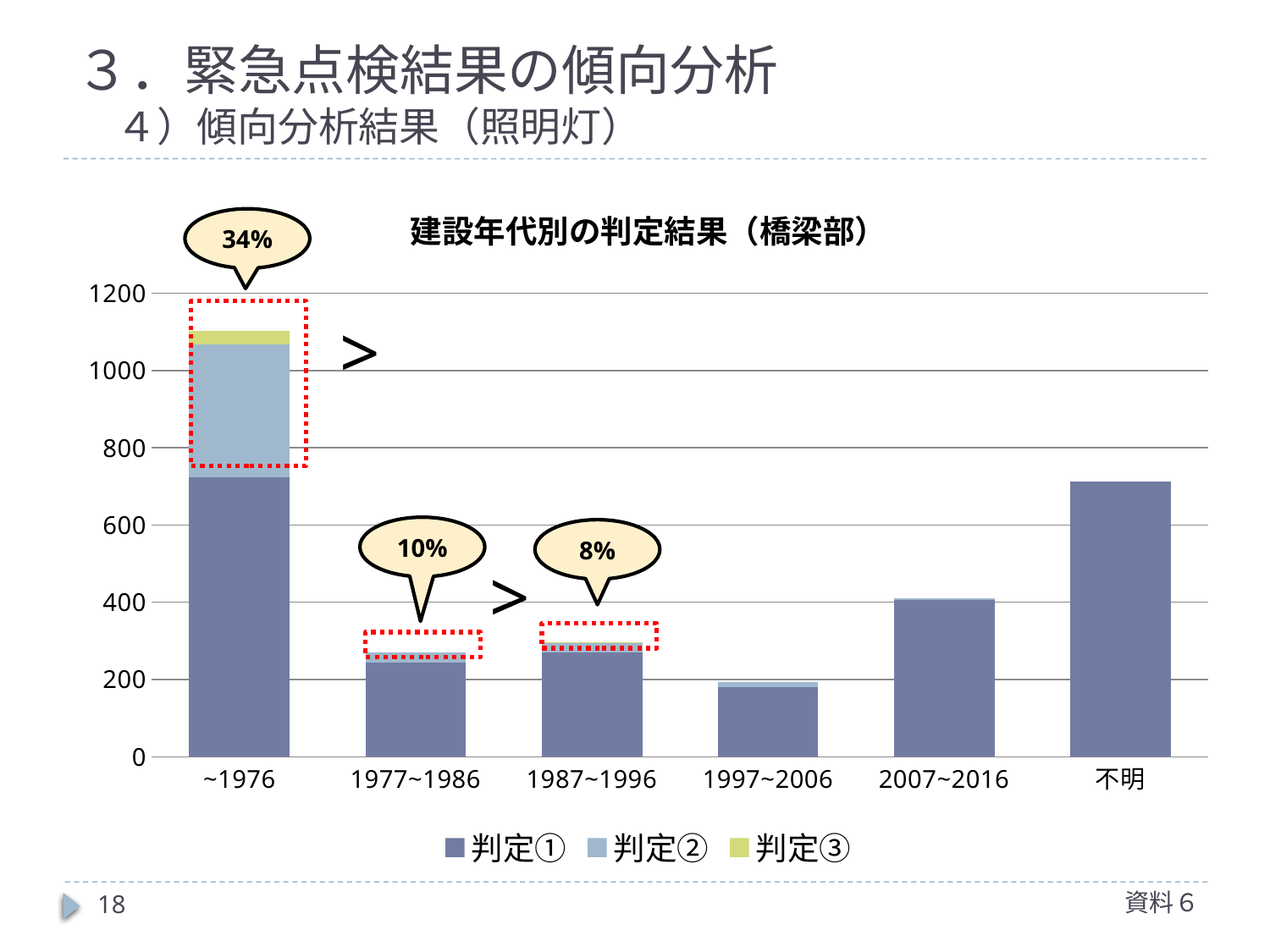
Is the total bar height for ~1976 greater or less than 1000? greater Which construction-period category has the shortest bar? 1997~2006 What is the title of the chart? 建設年代別の判定結果（橋梁部） What kind of chart is shown on the slide? Stacked bar chart How many series does the legend list? 3 What percentage is shown in the callout above the ~1976 bar? 34% Is the total bar height for 1977~1986 greater or less than 400? less What percentage is shown in the callout above the 1987~1996 bar? 8% Which bar is taller, 不明 or 2007~2016? 不明 How many construction-period categories are shown on the x axis? 6 Which construction-period category has the tallest bar? ~1976 Is the total bar height for 不明 greater or less than 600? greater